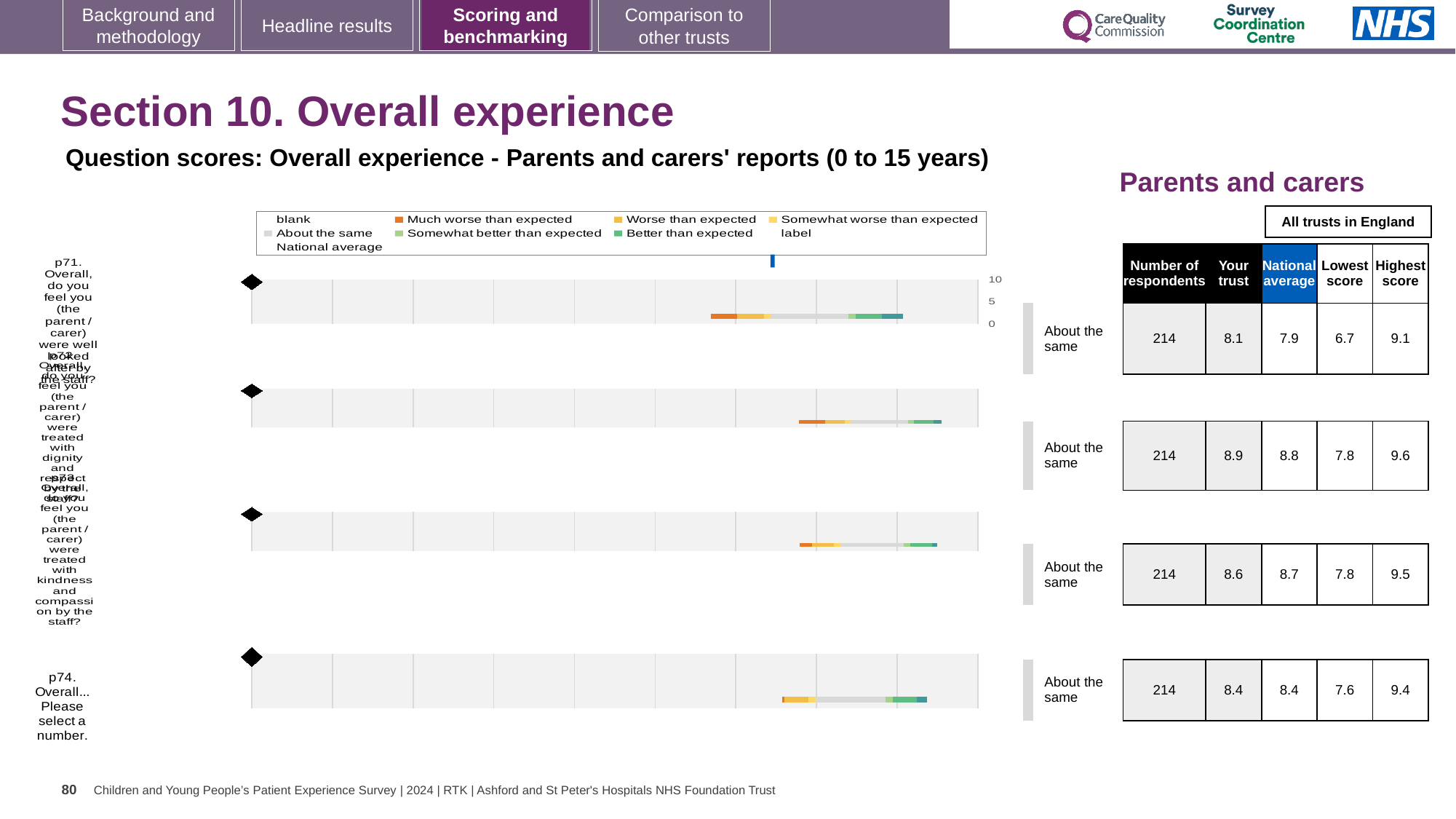
According to the table, what is the highest score across all trusts in England for p72? 9.6 According to the table, what is the 'Your trust' score for p74 (Overall... Please select a number)? 8.4 What is the last entry listed in the chart legend? National average According to the table, what is the lowest score across all trusts in England for p74? 7.6 What is the highest tick value shown on the chart's score axis? 10 What kind of chart is used to show the question scores on this slide? bar chart Which question has the highest 'Your trust' score in the table? p72 For p73, which is larger: the 'Your trust' score or the national average? National average What benchmark category is shown for p71 next to the chart? About the same What is the difference between the 'Your trust' score and the national average for p71? 0.2 According to the table, how many respondents answered p71? 214 How many questions (rows) are plotted in the chart? 4